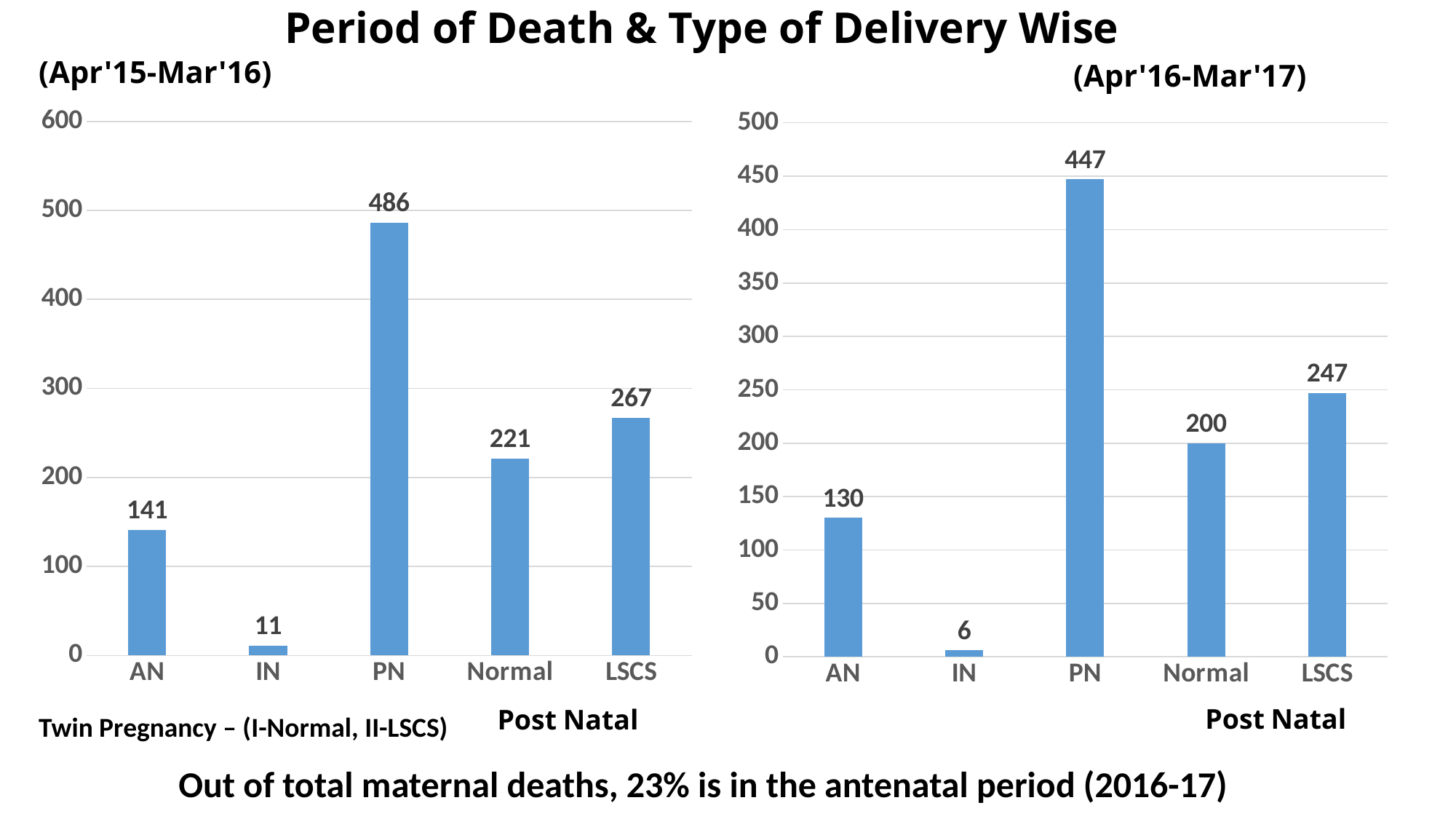
What kind of chart is the Apr'15-Mar'16 chart? bar chart In the Apr'16-Mar'17 chart, what is the value for LSCS? 247 In the Apr'15-Mar'16 chart, what is the value for IN? 11 In the Apr'16-Mar'17 chart, which category has the highest value? PN In the Apr'15-Mar'16 chart, which category has the lowest value? IN In the Apr'15-Mar'16 chart, what is the value for PN? 486 What is the title of the slide's charts? Period of Death & Type of Delivery Wise In the Apr'16-Mar'17 chart, what is the difference between the values for LSCS and Normal? 47 In the Apr'15-Mar'16 chart, what is the difference between the values for PN and AN? 345 In the Apr'16-Mar'17 chart, which is larger, the value for AN or the value for Normal? Normal In the Apr'15-Mar'16 chart, is the value for LSCS greater or less than 300? less How many categories are shown in the Apr'16-Mar'17 chart? 5